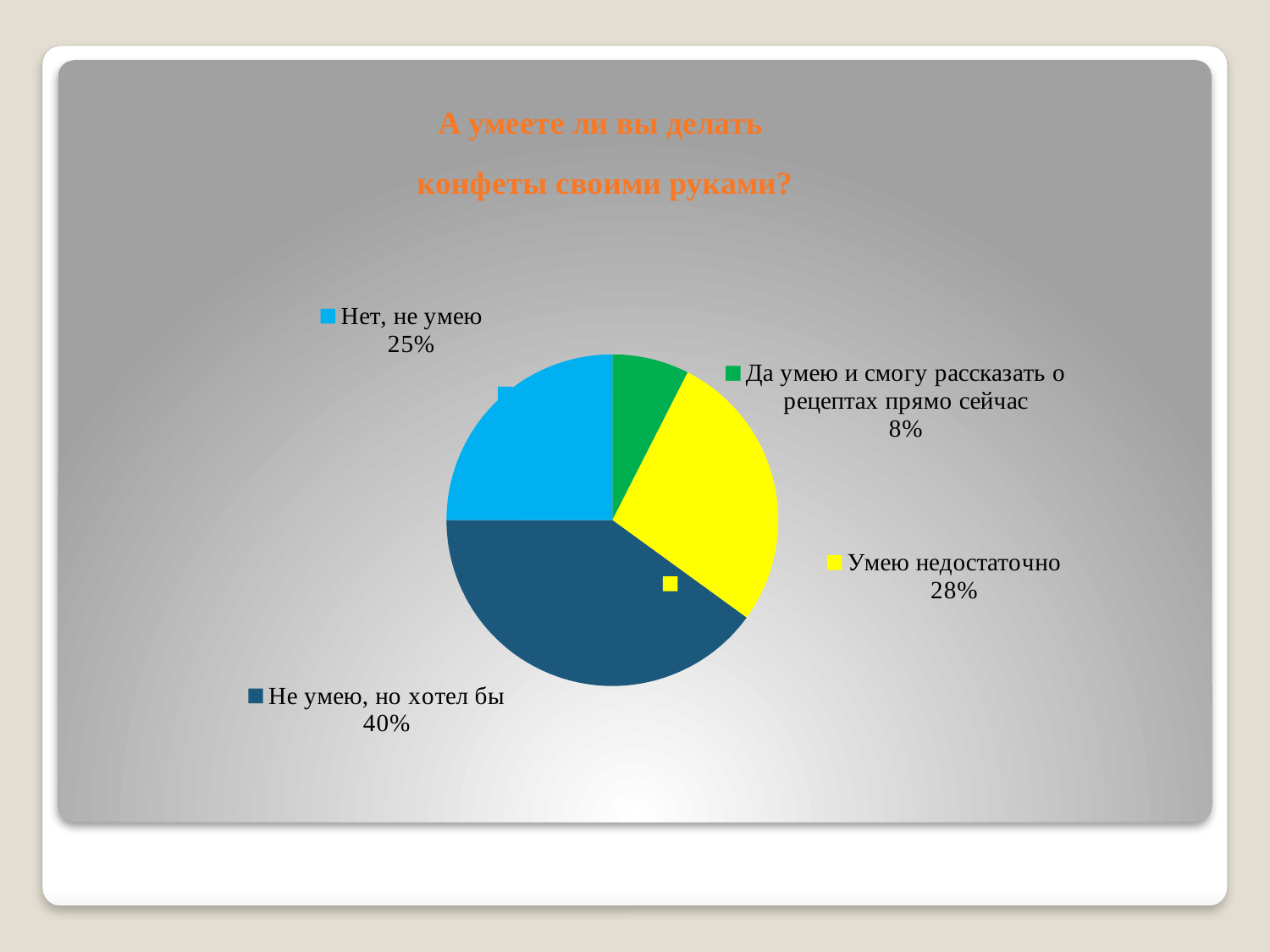
Which answer has the smallest share of the pie? Да умею и смогу рассказать о рецептах прямо сейчас What percentage of respondents answered "Умею недостаточно"? 28% What percentage of respondents answered "Да умею и смогу рассказать о рецептах прямо сейчас"? 8% How many slices does the pie chart have? 4 What colour is the slice for "Умею недостаточно"? yellow What percentage of respondents answered "Не умею, но хотел бы"? 40% Which is larger: the share for "Умею недостаточно" or the share for "Нет, не умею"? Умею недостаточно Which answer has the largest share of the pie? Не умею, но хотел бы What kind of chart is shown on the slide? pie chart What is the difference in percentage points between "Не умею, но хотел бы" and "Нет, не умею"? 15 What percentage of respondents answered "Нет, не умею"? 25% What is the title of the chart? А умеете ли вы делать конфеты своими руками?